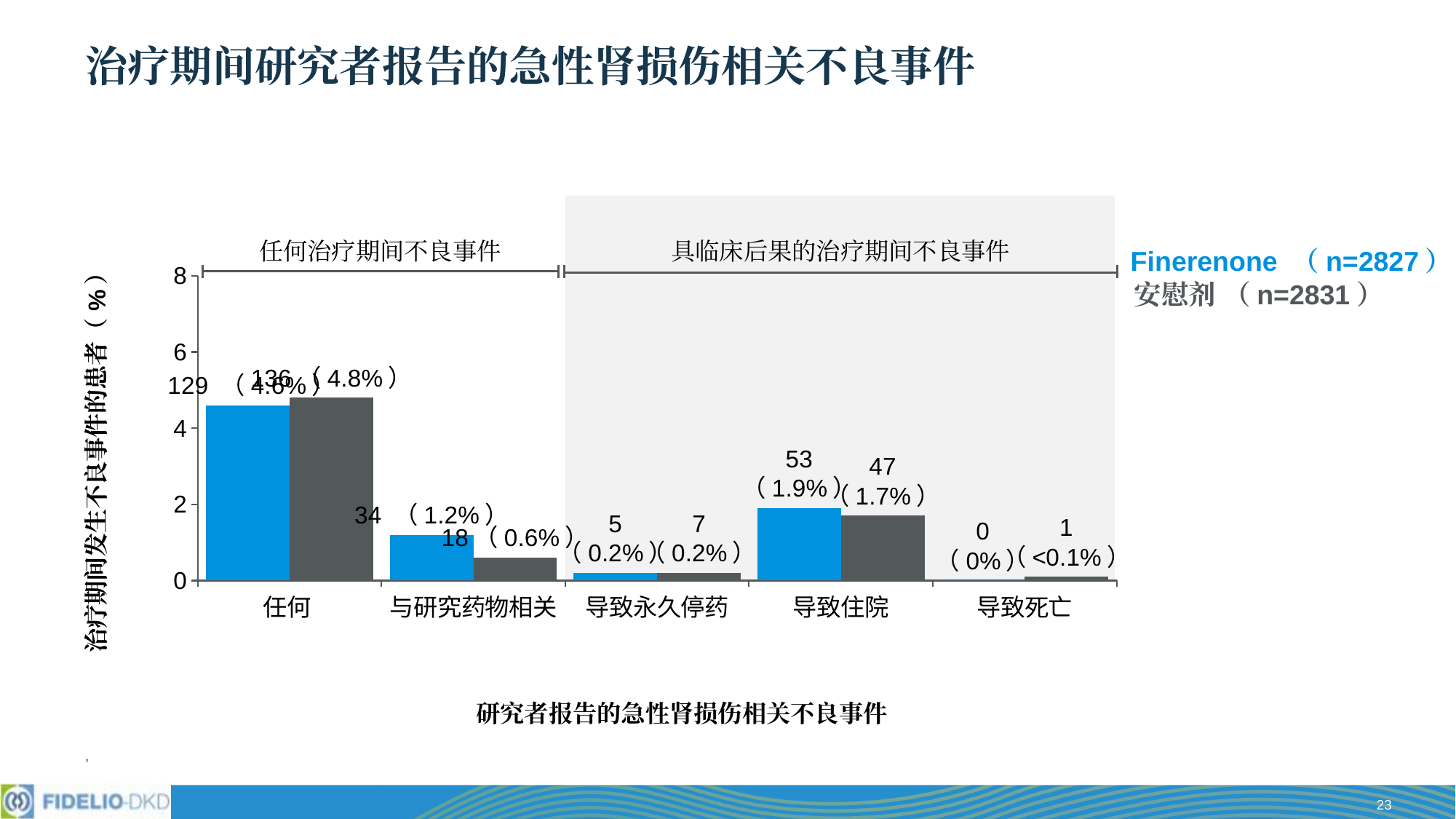
How many placebo (安慰剂) patients had an AKI adverse event leading to death (导致死亡)? 1 Which category has the highest value for the Finerenone group? 任何 What type of chart is shown on the slide? Bar chart How many series does the chart show? 2 What is the difference in the number of patients with an AKI event leading to hospitalization (导致住院) between Finerenone (53) and placebo (47)? 6 Which category has the lowest value for the Finerenone group? 导致死亡 What is the number of patients with a treatment-emergent AKI adverse event leading to hospitalization (导致住院) in the Finerenone group? 53 How many placebo (安慰剂) patients had any (任何) treatment-emergent AKI adverse event? 136 What percentage of placebo (安慰剂) patients had an AKI adverse event leading to hospitalization (导致住院)? 1.7% For AKI events related to study drug (与研究药物相关), which group has the larger value, Finerenone or 安慰剂? Finerenone How many categories are shown on the x axis? 5 How many Finerenone patients had an AKI adverse event leading to permanent discontinuation (导致永久停药)? 5